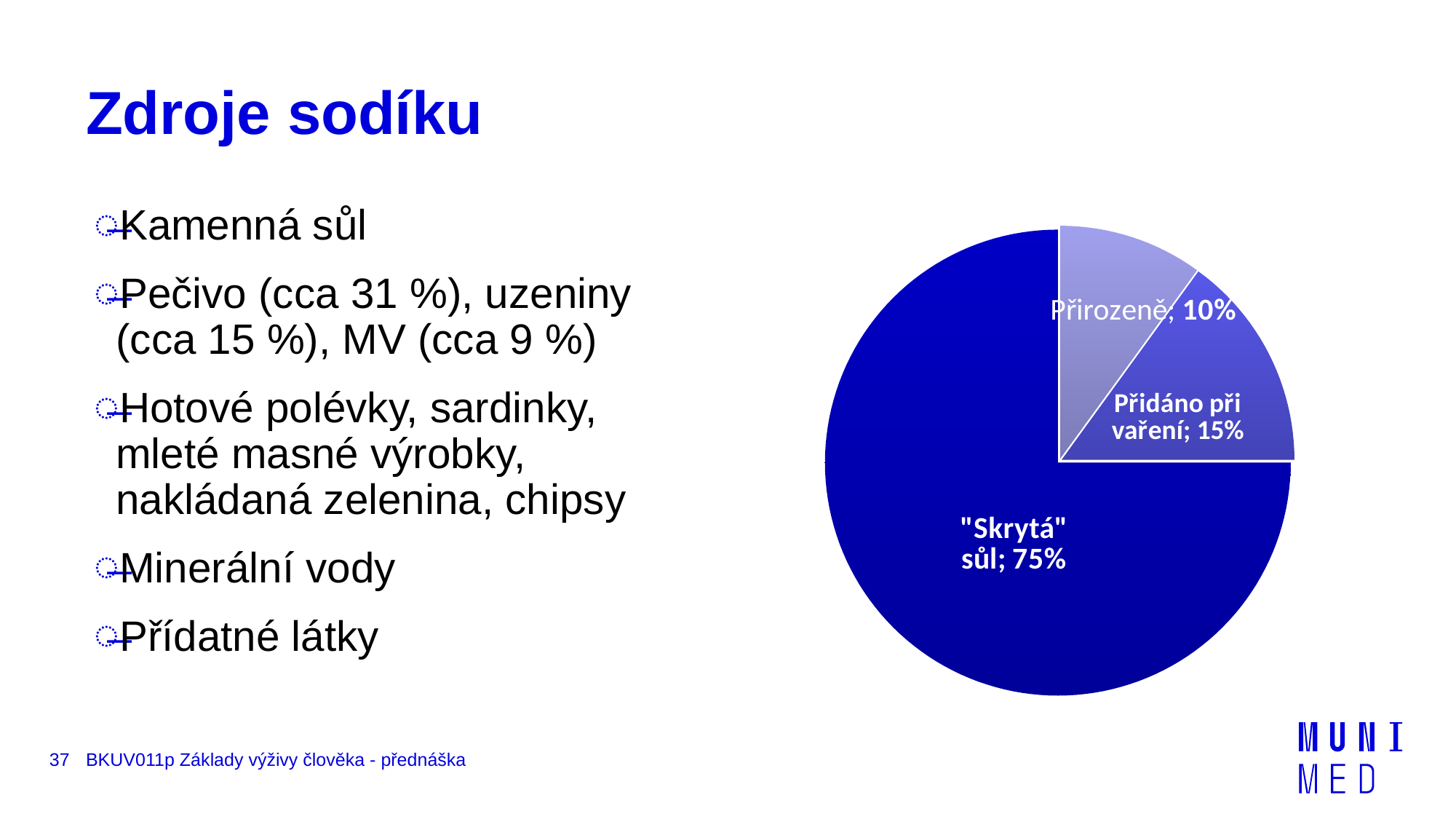
Which is larger, Přidáno při vaření or Přirozeně? Přidáno při vaření What is the combined share of Přidáno při vaření and Přirozeně? 25% What is the difference between the "Skrytá" sůl slice and the Přidáno při vaření slice? 60% What is the difference between the Přidáno při vaření slice and the Přirozeně slice? 5% Which slice of the pie is the largest? "Skrytá" sůl What share of the pie does "Skrytá" sůl represent? 75% How many slices does the pie chart have? 3 What is the value for Přirozeně? 10% Which slice of the pie is drawn in the darkest blue? "Skrytá" sůl Which slice of the pie is the smallest? Přirozeně What is the value for Přidáno při vaření? 15% What kind of chart is shown on the slide? pie chart